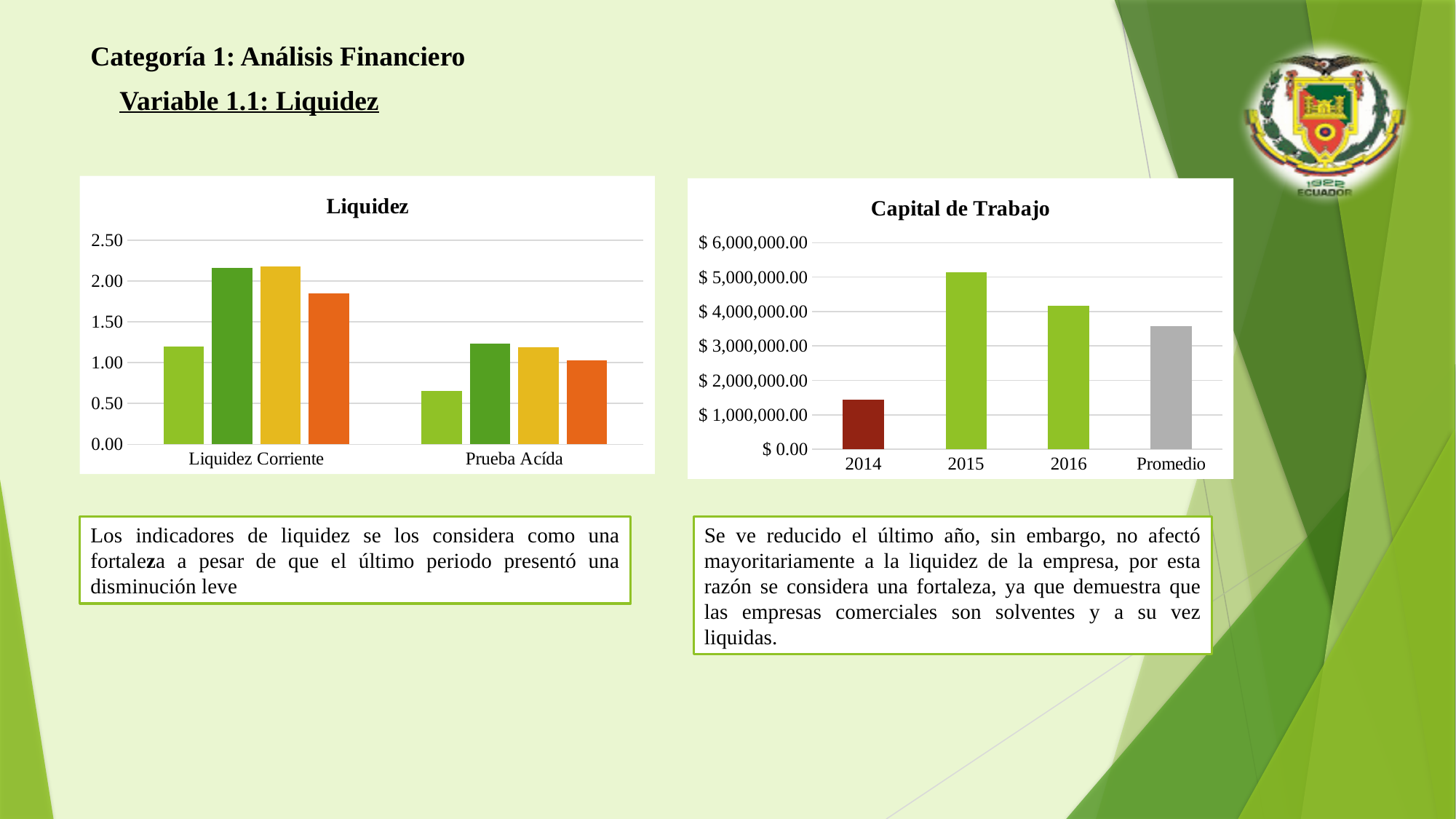
How many categories are shown on the x axis of the 'Capital de Trabajo' chart? 4 How many categories are shown on the x axis of the 'Liquidez' chart? 2 In the 'Capital de Trabajo' chart, is the value for 2016 greater or less than $ 4,000,000.00? greater In the 'Capital de Trabajo' chart, is the value for 2014 greater or less than $ 2,000,000.00? less In the 'Capital de Trabajo' chart, which year has the highest value? 2015 In the 'Liquidez' chart, which category has the taller bars, Liquidez Corriente or Prueba Acída? Liquidez Corriente In the 'Capital de Trabajo' chart, is the value for 2015 greater or less than $ 5,000,000.00? greater In the 'Capital de Trabajo' chart, which category has the lowest value? 2014 In the 'Capital de Trabajo' chart, does the value rise or fall from 2015 to 2016? fall What kind of chart is the 'Capital de Trabajo' chart? bar chart In the 'Capital de Trabajo' chart, which is larger, the value for 2015 or the value for 2016? 2015